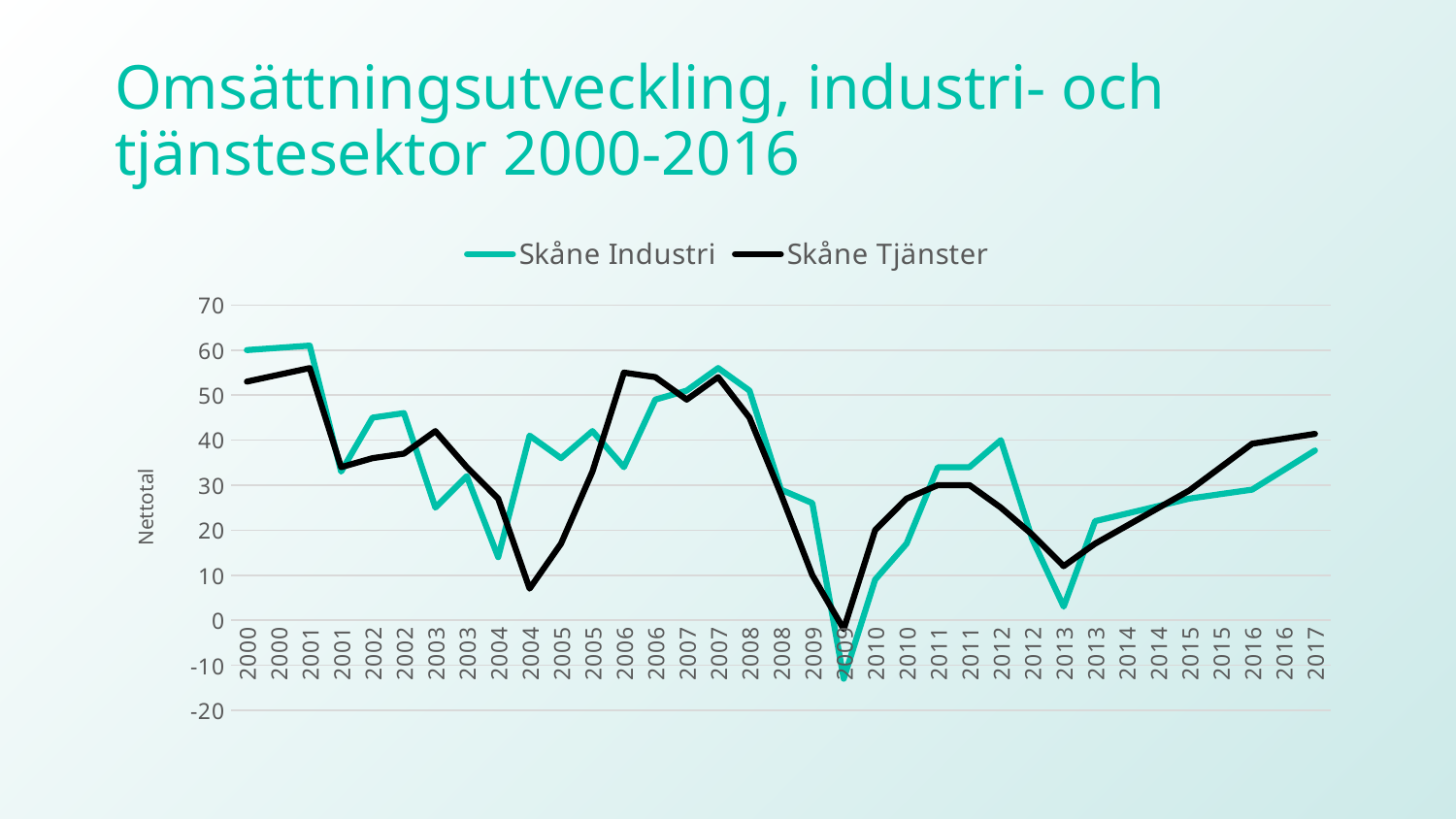
What are the two series named in the legend? Skåne Industri and Skåne Tjänster At which x-axis point does Skåne Industri reach its lowest value? The second 2009 point Is the value for Skåne Industri at the first 2013 point greater or less than 10? less Is the value for Skåne Tjänster at 2017 greater or less than 30? greater Is the value for Skåne Tjänster at the second 2004 point greater or less than 10? less At the second 2004 point, which series has the higher value, Skåne Industri or Skåne Tjänster? Skåne Industri Does the Skåne Tjänster line rise or fall from the first 2013 point to 2017? Rise What is the label on the vertical axis? Nettotal How many series does the legend list? 2 What kind of chart is shown on the slide? Line chart